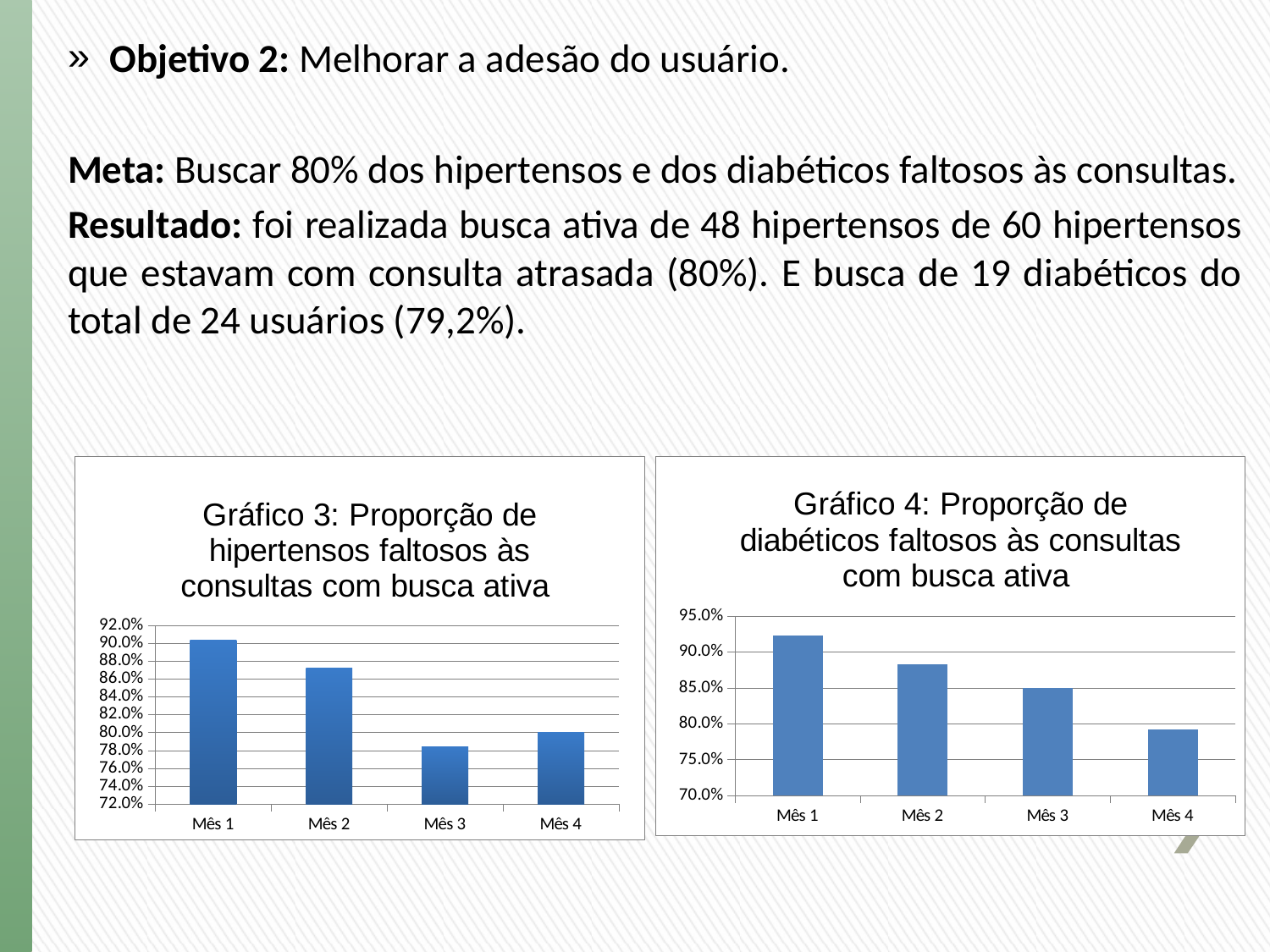
In Gráfico 3, which is larger, the value for Mês 3 or the value for Mês 4? Mês 4 In Gráfico 3, is the value for Mês 2 greater or less than 84.0%? greater In Gráfico 4, which month has the highest proportion? Mês 1 In Gráfico 3, which month has the highest proportion? Mês 1 In Gráfico 3, is the value for Mês 3 greater or less than 80.0%? less In Gráfico 3, which month has the lowest proportion? Mês 3 How many categories are shown on the x axis of Gráfico 4? 4 In Gráfico 4, is the value for Mês 4 greater or less than 80.0%? less What type of chart is Gráfico 3? bar chart Do the values in Gráfico 4 rise or fall from Mês 1 to Mês 4? fall In Gráfico 4, which month has the lowest proportion? Mês 4